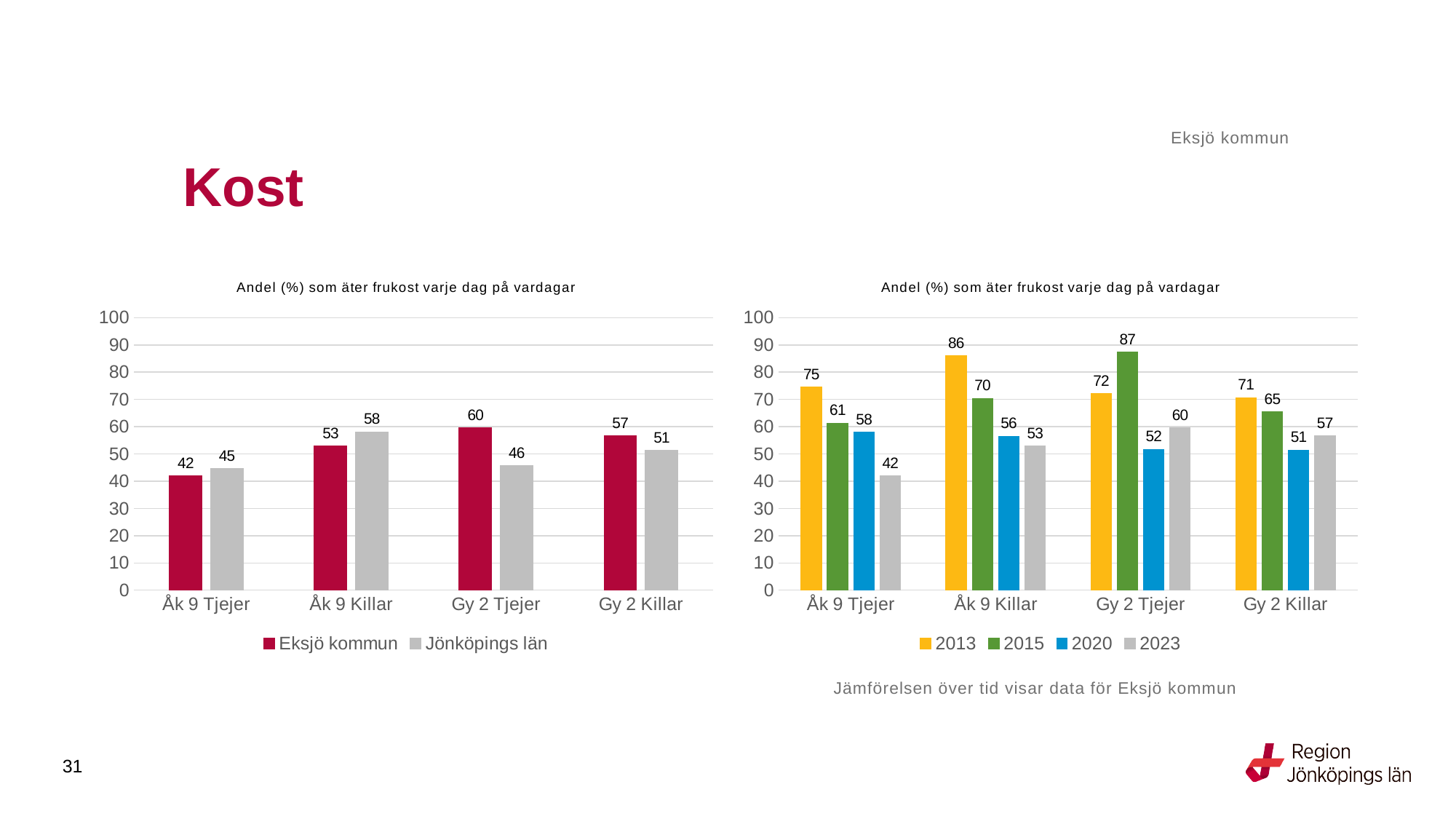
In the left chart, what is the value for Eksjö kommun for Åk 9 Tjejer? 42 In the left chart, which category has the highest value for Eksjö kommun? Gy 2 Tjejer In the right chart, what is the difference between the 2013 and 2023 values for Åk 9 Killar? 33 In the left chart, how many series does the legend list? 2 In the right chart, what is the value for 2015 for Gy 2 Tjejer? 87 In the left chart, what is the difference between Jönköpings län and Eksjö kommun for Åk 9 Killar? 5 In the right chart, which category has the lowest value for 2020? Gy 2 Killar In the right chart, what is the value for 2023 for Åk 9 Tjejer? 42 In the left chart, which is larger for Gy 2 Killar: Eksjö kommun or Jönköpings län? Eksjö kommun What kind of chart is the right chart? Bar chart In the left chart, what is the value for Jönköpings län for Gy 2 Tjejer? 46 In the right chart, how many series does the legend list? 4